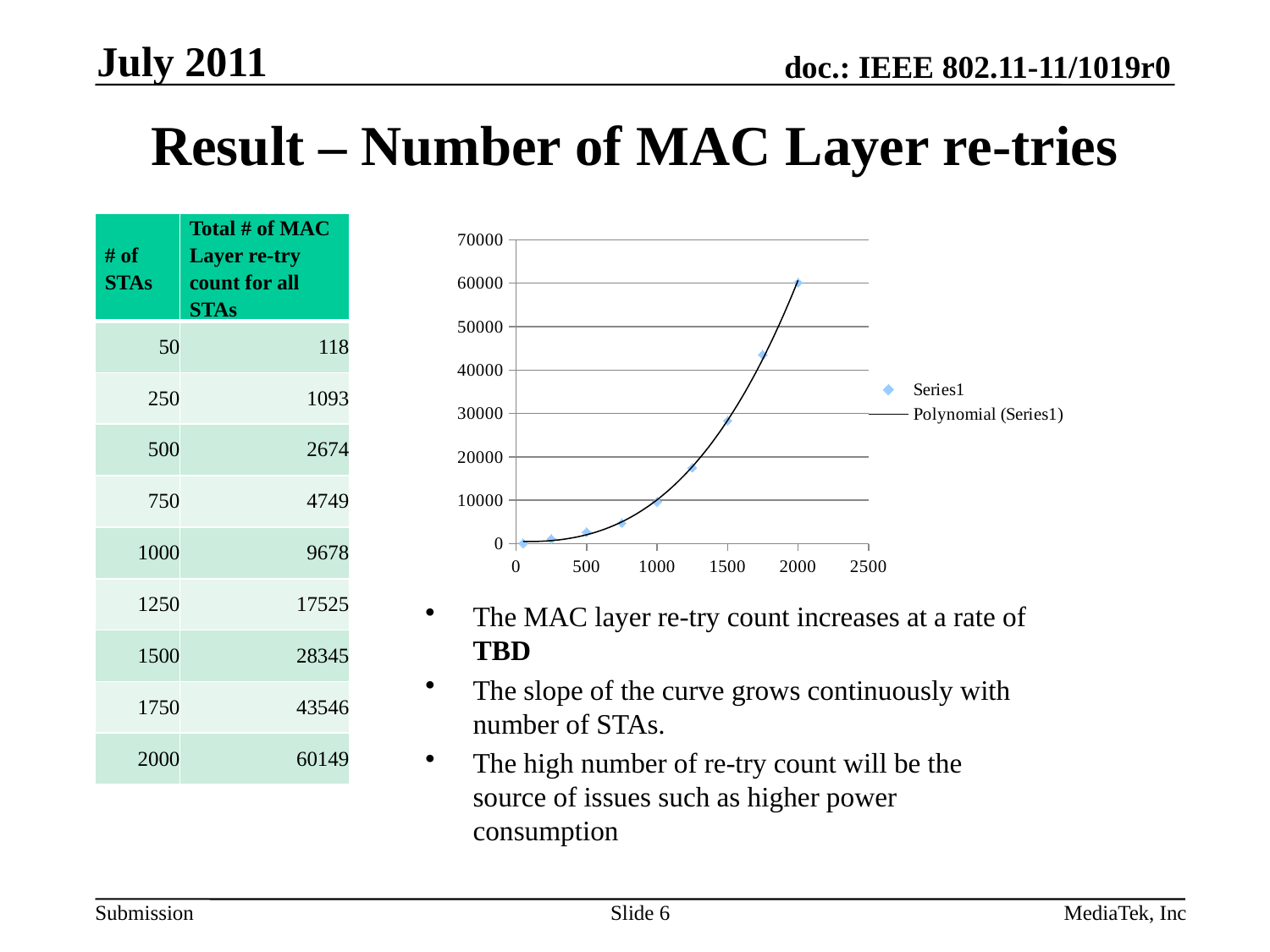
Is the plotted value at x = 2000 greater or less than 50000? greater Do the plotted values rise or fall as the x-axis value increases? rise Is the plotted value at x = 1750 greater or less than 40000? greater How many data points are plotted in the chart? 9 How many entries does the chart legend list? 2 What is the highest value shown on the chart's y-axis? 70000 Which plotted point is higher, the one at x = 1750 or the one at x = 1500? x = 1750 At which x-axis value does the chart reach its highest plotted point? 2000 What kind of chart is shown on the slide? scatter chart Is the plotted value at x = 1500 greater or less than 30000? less What are the two entries in the chart legend? Series1 and Polynomial (Series1)